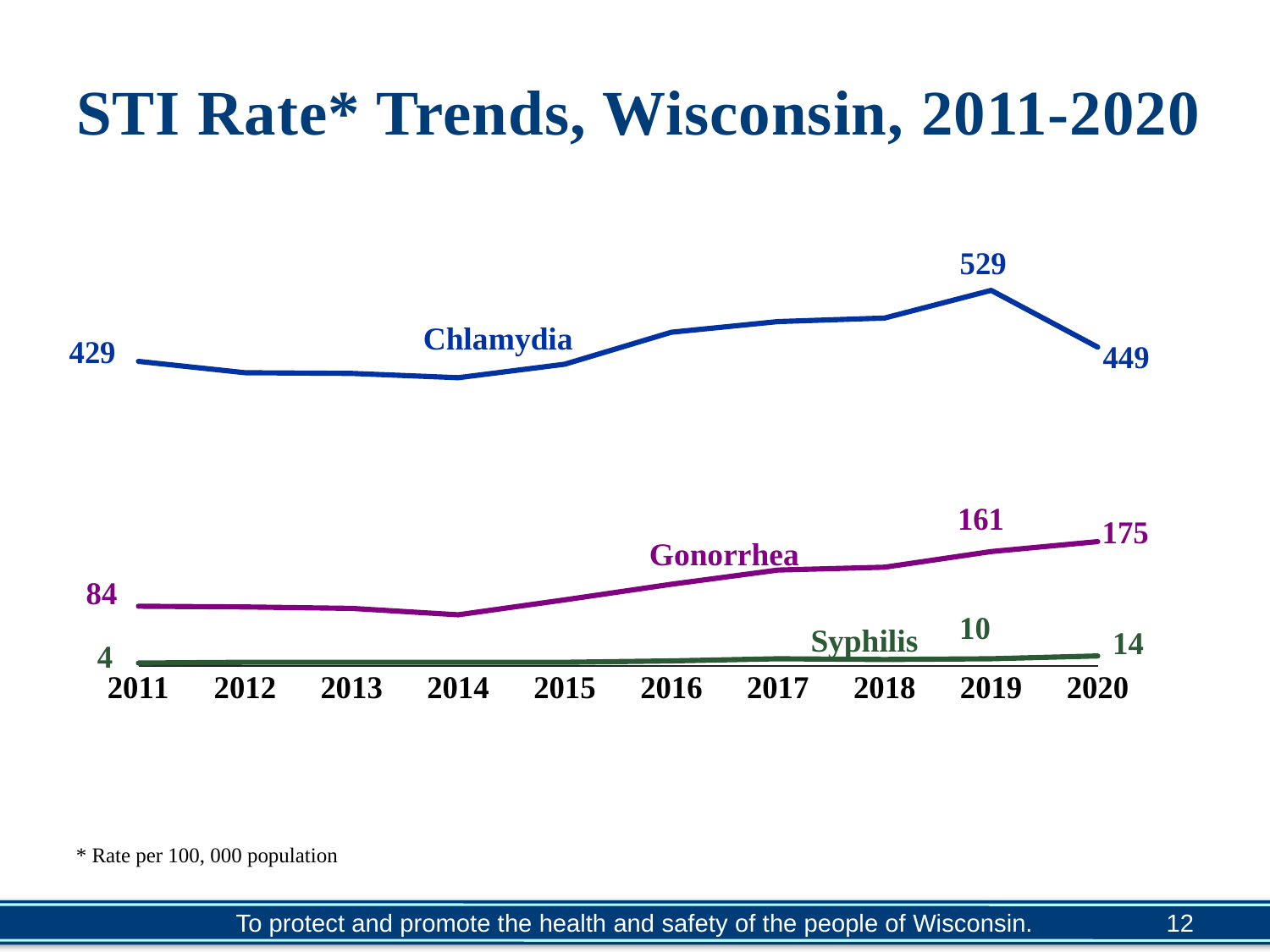
Which STI had the highest rate in 2020? Chlamydia What was the syphilis rate in 2011? 4 How many years are plotted along the x axis? 10 Which was larger, the gonorrhea rate in 2019 or in 2020? 2020 What was the syphilis rate in 2019? 10 What was the gonorrhea rate in 2020? 175 What was the chlamydia rate in Wisconsin in 2011? 429 What type of chart is shown on the slide? Line chart Which STI had the lowest rate in 2011? Syphilis What was the chlamydia rate in 2019? 529 By how much did the chlamydia rate fall from 2019 to 2020? 80 How much higher was the gonorrhea rate in 2020 than in 2011? 91